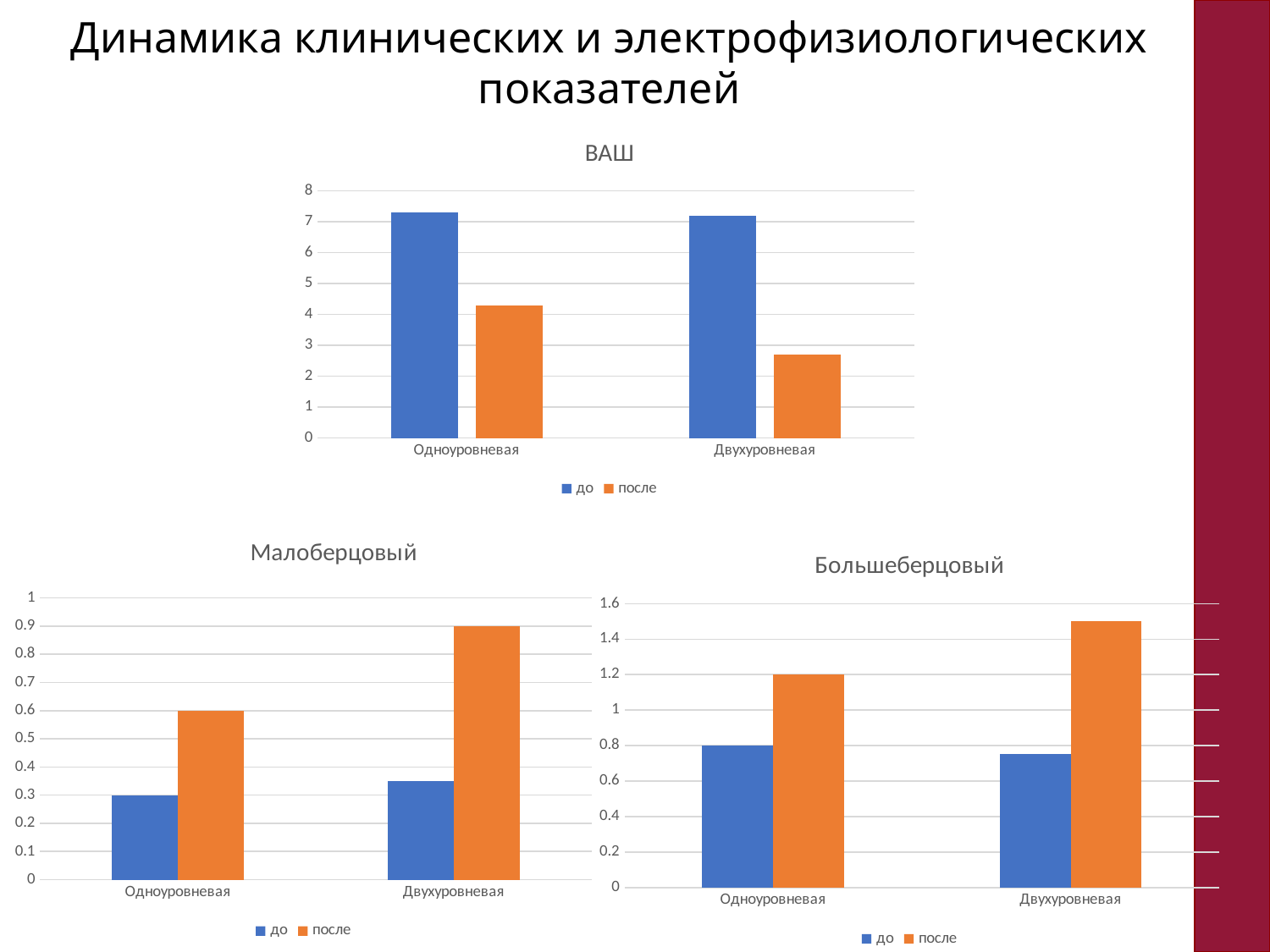
On the Большеберцовый chart, what is the difference between после and до for Одноуровневая? 0.4 On the ВАШ chart, is the value for до for Одноуровневая greater or less than 7? greater What kind of chart is the ВАШ chart? bar chart On the Малоберцовый chart, what is the value for после for Двухуровневая? 0.9 On the Малоберцовый chart, what is the difference between после and до for Одноуровневая? 0.3 On the ВАШ chart, which bar is the lowest? Двухуровневая, после On the ВАШ chart, which is larger for Одноуровневая: до or после? до On the Малоберцовый chart, what is the value for до for Одноуровневая? 0.3 How many series does the legend of the Большеберцовый chart list? 2 On the ВАШ chart, is the value for после for Двухуровневая greater or less than 3? less On the Большеберцовый chart, is the value for после for Двухуровневая greater or less than 1.4? greater On the Большеберцовый chart, what is the value for после for Одноуровневая? 1.2